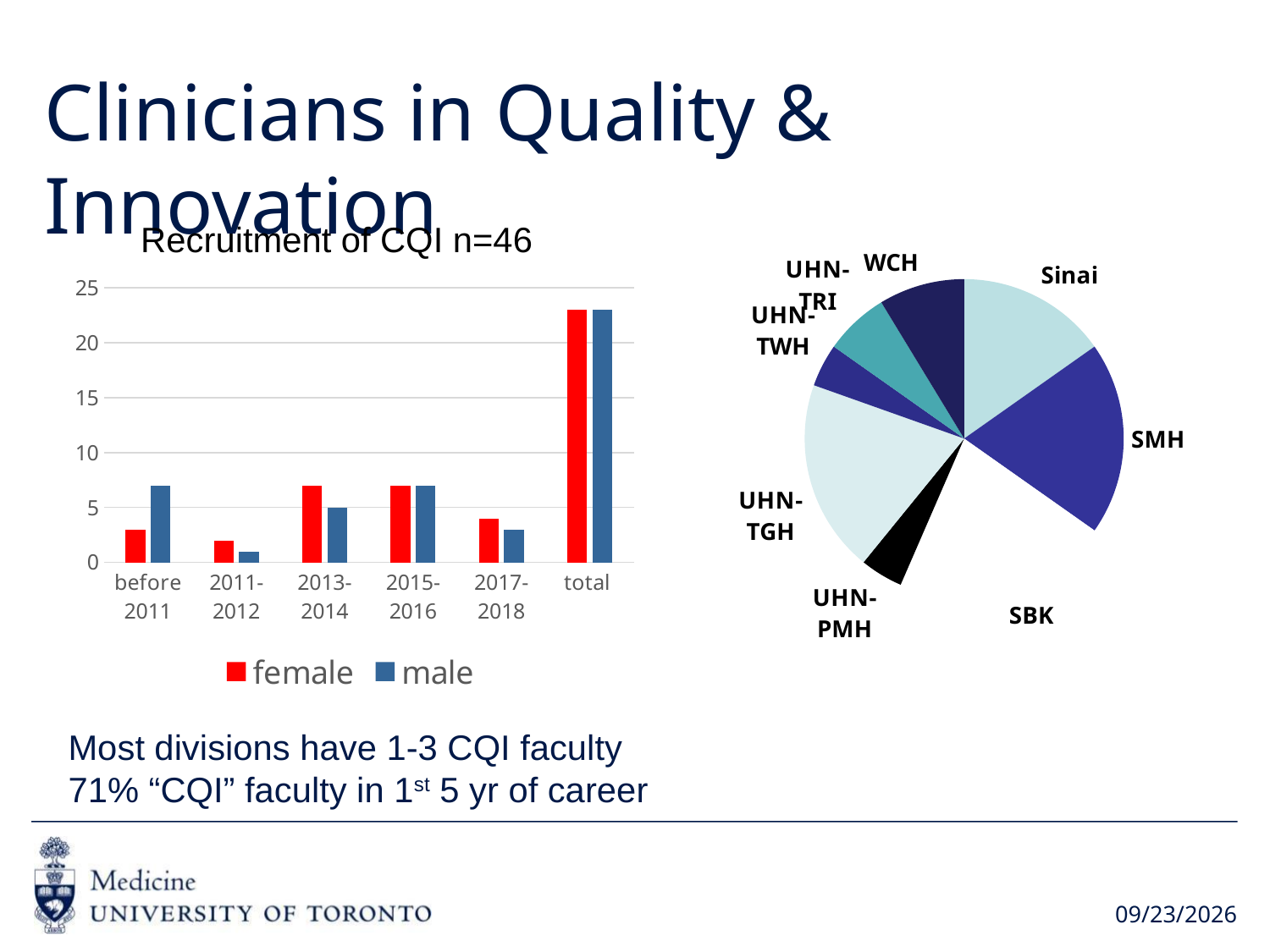
What kind of chart is the left chart titled 'Recruitment of CQI n=46'? bar chart What kind of chart is the chart on the right of the slide? pie chart In the pie chart on the right, how many slices are there? 8 In the 'Recruitment of CQI n=46' chart, which is larger for '2013-2014', the female or the male value? female In the 'Recruitment of CQI n=46' chart, is the male value for '2011-2012' greater or less than 5? less In the 'Recruitment of CQI n=46' chart, is the female value for 'total' greater or less than 20? greater In the 'Recruitment of CQI n=46' chart, what are the two series named in the legend? female and male In the 'Recruitment of CQI n=46' chart, how many series does the legend list? 2 In the 'Recruitment of CQI n=46' chart, how many categories are shown on the x axis? 6 In the 'Recruitment of CQI n=46' chart, which is larger for 'before 2011', the female or the male value? male In the 'Recruitment of CQI n=46' chart, is the male value for 'before 2011' greater or less than 5? greater